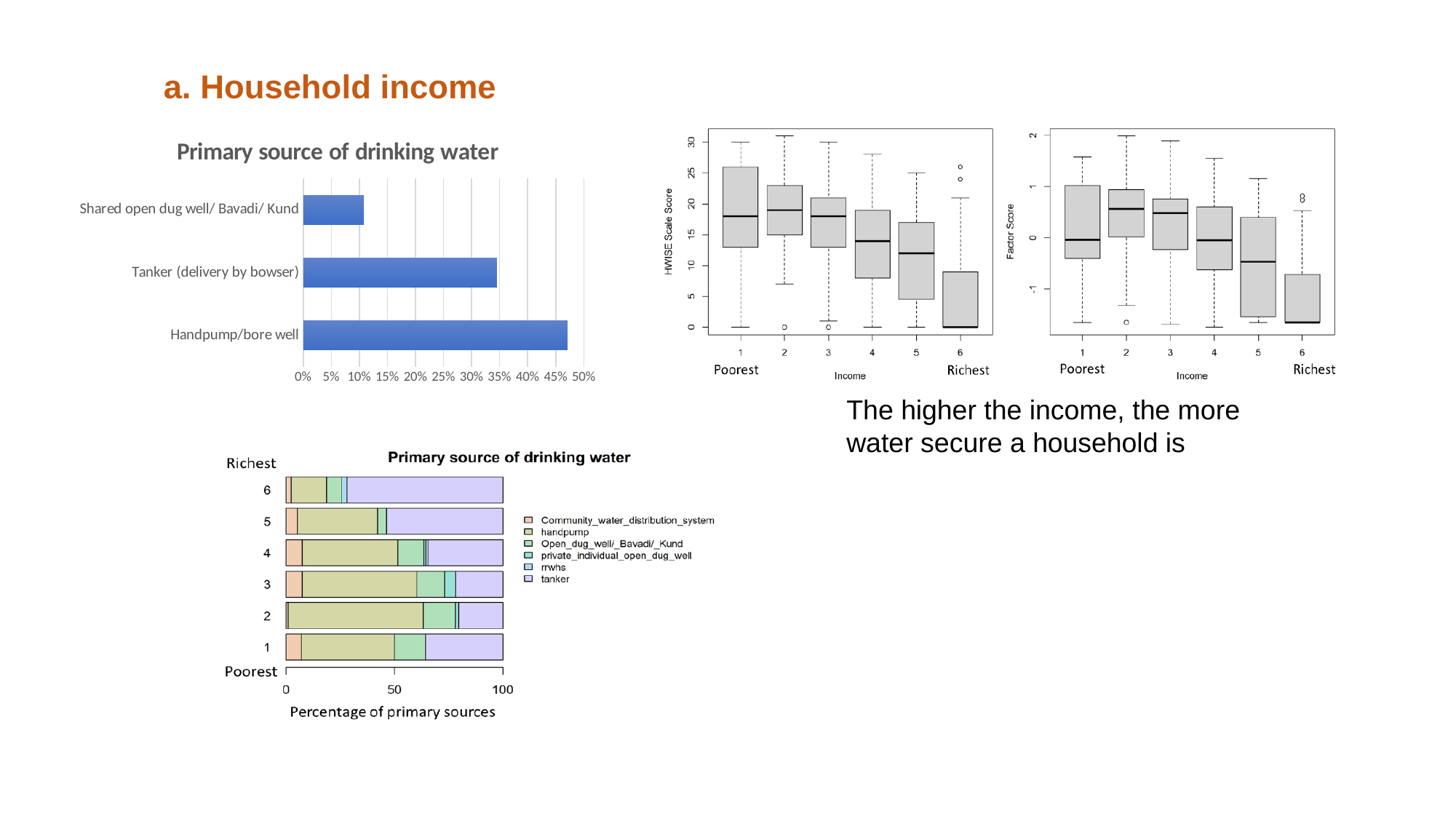
In the top-left 'Primary source of drinking water' bar chart, is the value for Tanker (delivery by bowser) greater or less than 40%? less What kind of chart is the top-left 'Primary source of drinking water' chart? Bar chart In the top-left 'Primary source of drinking water' bar chart, which source has the highest percentage? Handpump/bore well In the top-left 'Primary source of drinking water' bar chart, is the value for Handpump/bore well greater or less than 40%? greater In the HWISE Scale Score box plot, is the median for income group 6 greater or less than 5? less How many series does the legend of the bottom-left stacked 'Primary source of drinking water' chart list? 6 How many income groups (bars) are shown in the bottom-left stacked 'Primary source of drinking water' chart? 6 In the top-left 'Primary source of drinking water' bar chart, which is larger: Tanker (delivery by bowser) or Shared open dug well/ Bavadi/ Kund? Tanker (delivery by bowser) In the HWISE Scale Score box plot, how does the median score change as income group goes from 1 (Poorest) to 6 (Richest)? It falls In the top-left 'Primary source of drinking water' bar chart, which source has the lowest percentage? Shared open dug well/ Bavadi/ Kund How many categories are shown in the top-left 'Primary source of drinking water' bar chart? 3